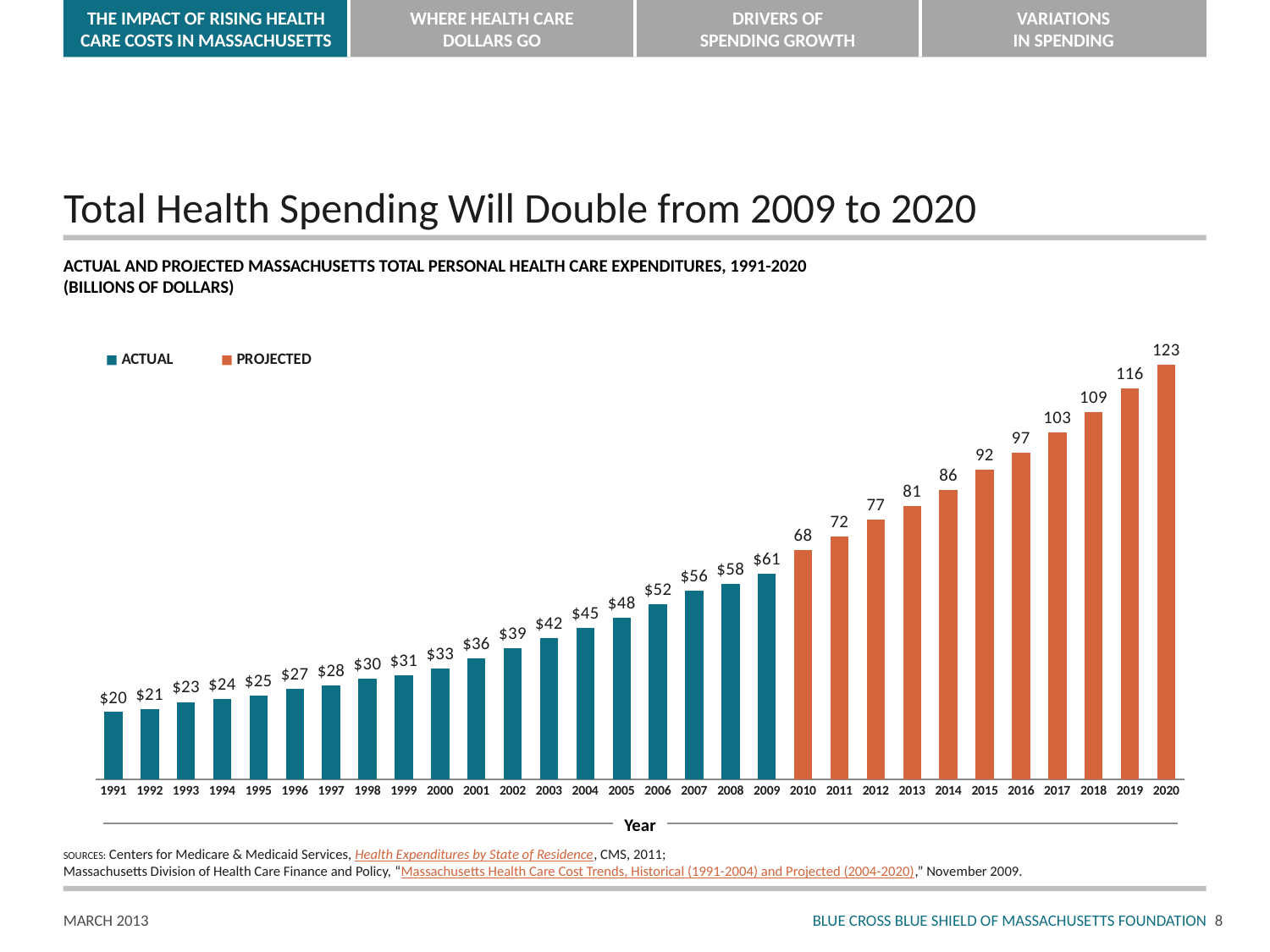
What is the projected value for 2020? 123 What is the value for 2001? $36 Which year has the lowest value? 1991 Do the values rise or fall from 1991 to 2020? Rise What kind of chart is this? Bar chart How many years are shown on the x axis? 30 How many series does the legend list? 2 Which year has the highest value? 2020 What is the projected value for 2015? 92 What is the difference between the values for 2020 and 2009? 62 Which is larger, the value for 2005 or the value for 2012? 2012 What is the value for 2009? $61